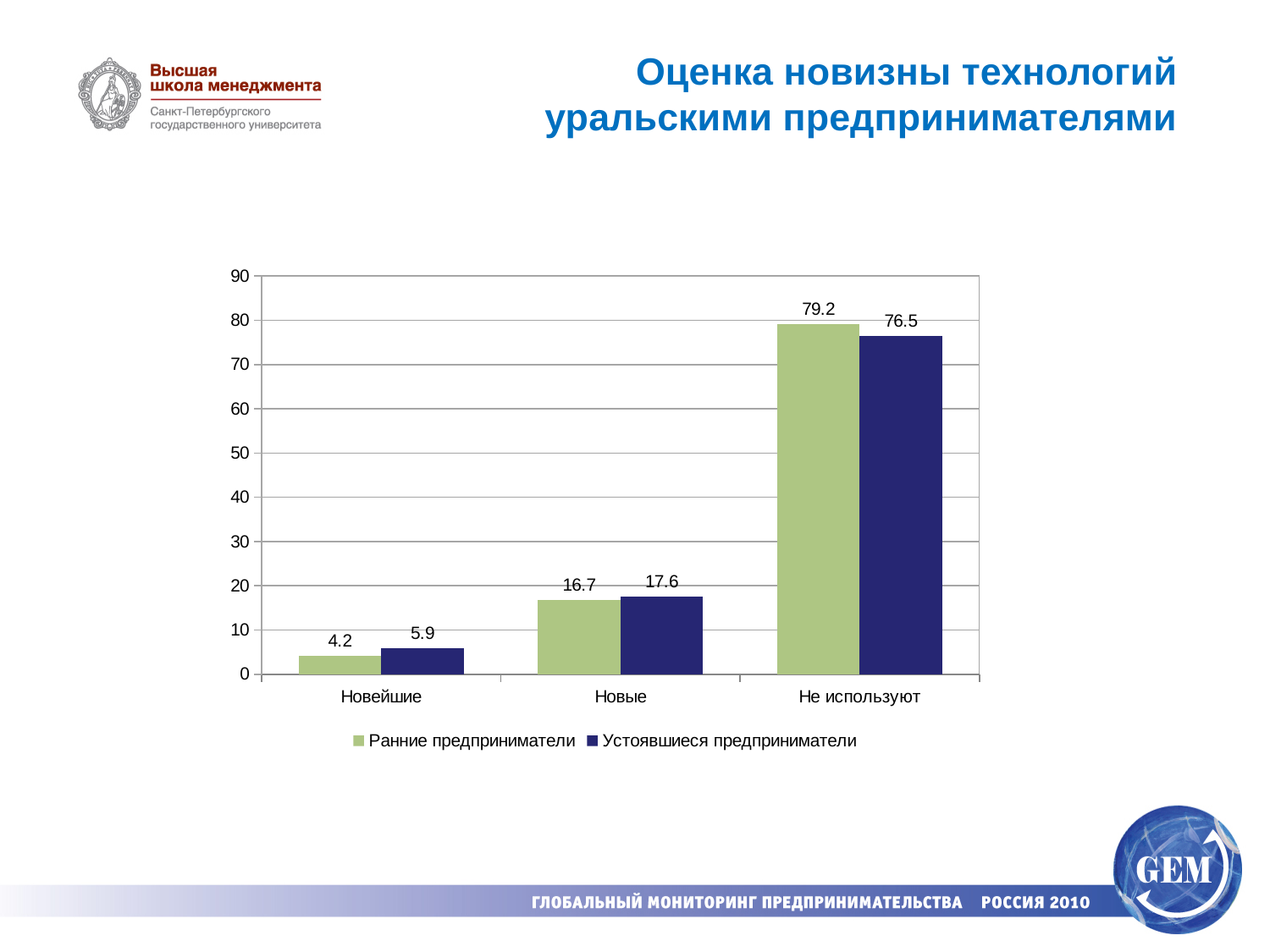
What is the difference between Ранние предприниматели and Устоявшиеся предприниматели in the Не используют category? 2.7 Which colour represents Ранние предприниматели in the chart? green Which category has the highest value for Ранние предприниматели? Не используют Is the value for Ранние предприниматели in the Не используют category greater or less than 70? greater What kind of chart is shown on the slide? bar chart How many series does the legend list? 2 Which category has the lowest value for Устоявшиеся предприниматели? Новейшие What is the value for Ранние предприниматели in the Новейшие category? 4.2 How many categories are shown on the x axis? 3 What is the value for Устоявшиеся предприниматели in the Новые category? 17.6 In the Новейшие category, which series has the larger value: Ранние предприниматели or Устоявшиеся предприниматели? Устоявшиеся предприниматели What is the value for Устоявшиеся предприниматели in the Не используют category? 76.5